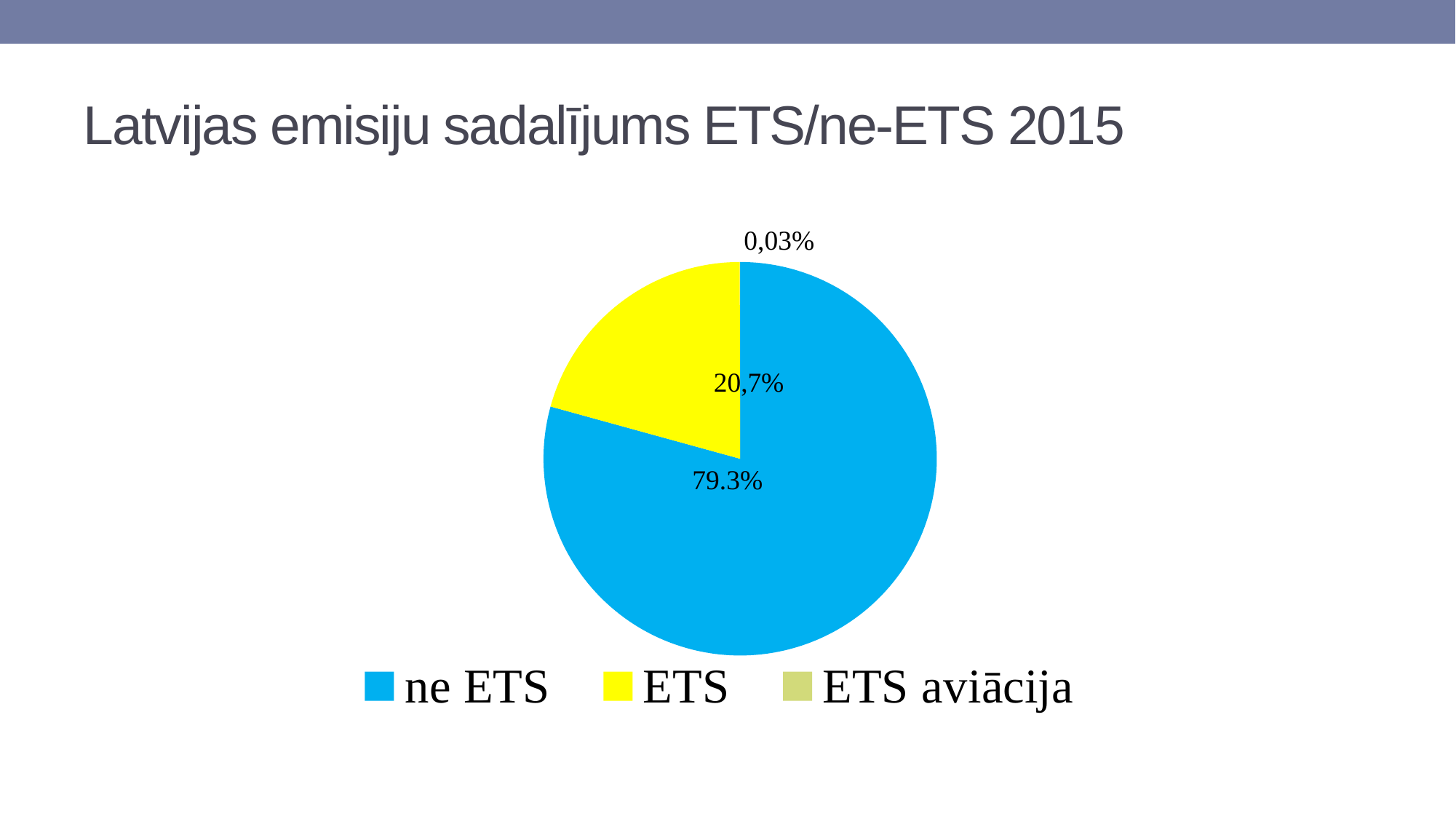
Which category has the largest slice of the pie? ne ETS How many categories does the legend list? 3 What share of the pie does the "ne ETS" slice have? 79.3% What is the title of the chart on the slide? Latvijas emisiju sadalījums ETS/ne-ETS 2015 What colour is the "ETS" slice in the pie chart? yellow What kind of chart is shown on the slide? pie chart What share of the pie does the "ETS" slice have? 20,7% What share of the pie does the "ETS aviācija" slice have? 0,03% Which category has the smallest slice of the pie? ETS aviācija Which is larger, the "ne ETS" slice or the "ETS" slice? ne ETS Which is larger, the "ETS" slice or the "ETS aviācija" slice? ETS